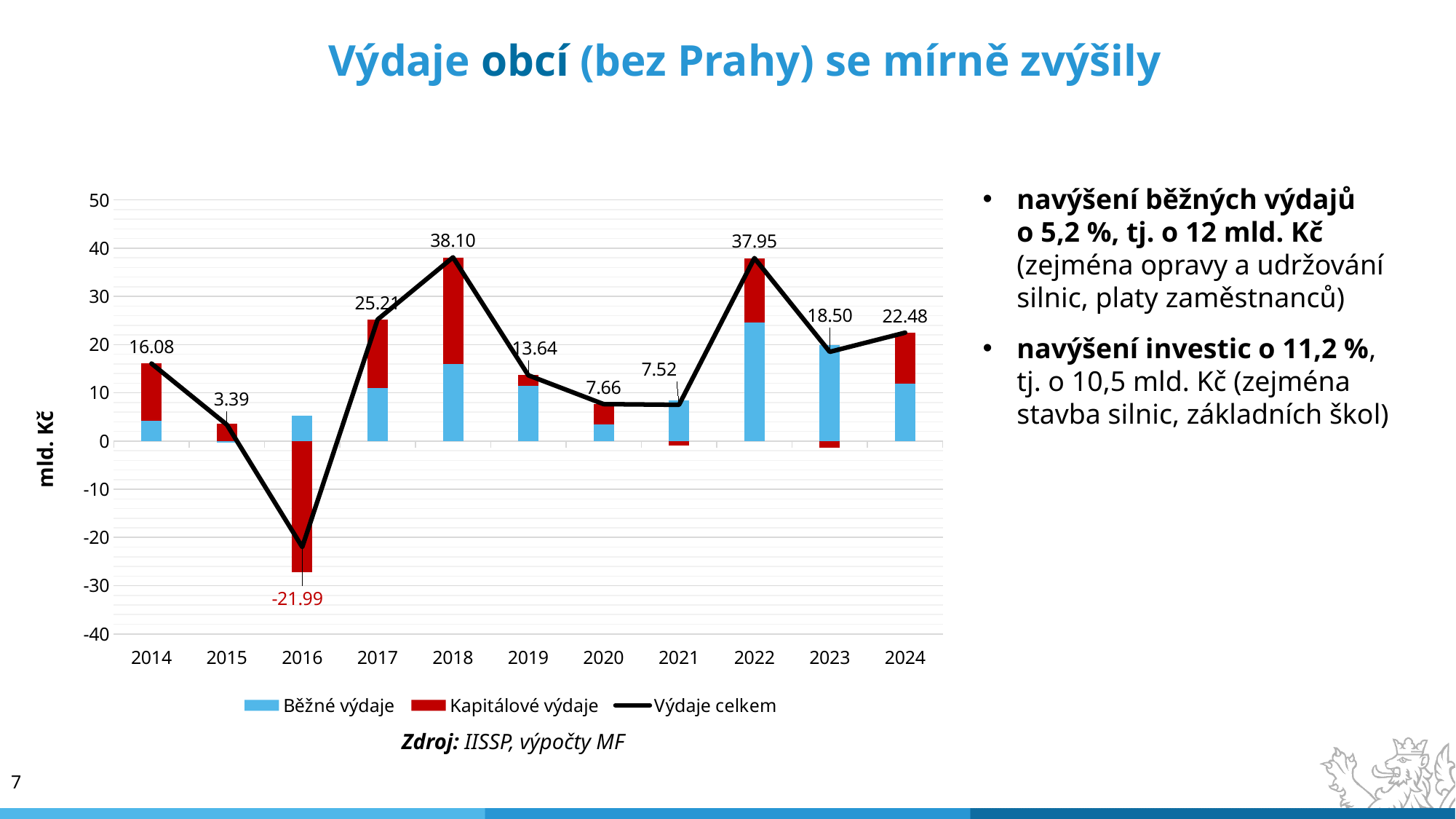
Which year has the larger Výdaje celkem, 2020 or 2021? 2020 How many series does the legend list? 3 What is the label of the vertical axis? mld. Kč Is the value of Běžné výdaje in 2022 greater or less than 20? greater How many years are shown on the x axis? 11 In which year is Výdaje celkem lowest? 2016 What is the value of Výdaje celkem in 2018? 38.10 What is the difference between Výdaje celkem in 2024 and in 2023? 3.98 What kind of chart is shown on the slide? Combined stacked bar and line chart In which year is Výdaje celkem highest? 2018 What is the value of Výdaje celkem in 2024? 22.48 What is the value of Výdaje celkem in 2016? -21.99